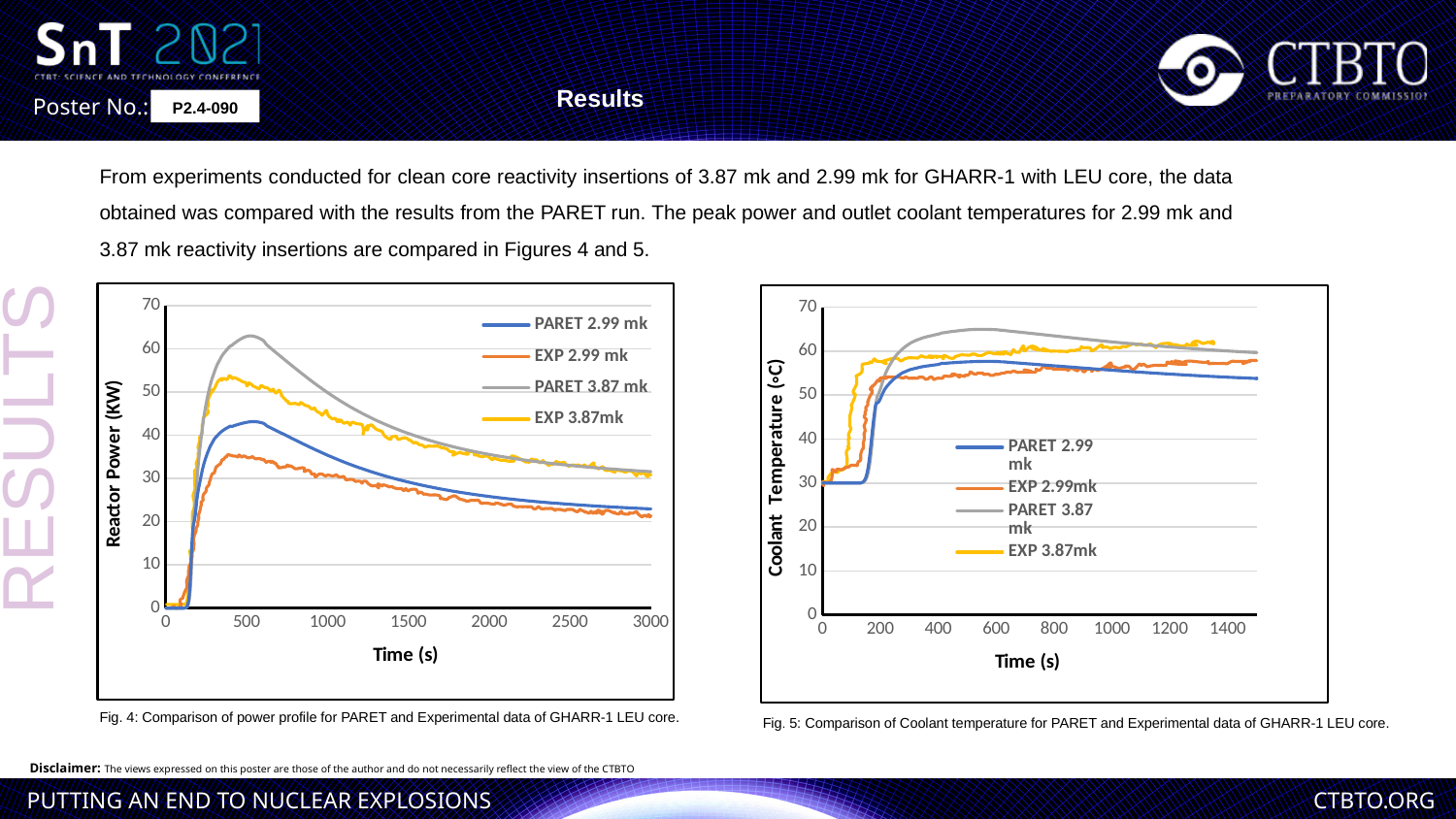
In the left chart (Fig. 4), is the peak value of EXP 2.99 mk greater or less than 40? less In the right chart (Fig. 5), is the value of PARET 2.99 mk at 1400 s greater or less than 60? less What kind of chart is the left chart (Fig. 4)? line chart How many series does the legend of the right chart (Fig. 5) list? 4 How many series does the legend of the left chart (Fig. 4) list? 4 In the left chart (Fig. 4), is the peak value of PARET 3.87 mk greater or less than 60? greater What is the y-axis label of the left chart (Fig. 4)? Reactor Power (KW) In the left chart (Fig. 4), does the PARET 2.99 mk series rise or fall between 1000 s and 3000 s? fall In the left chart (Fig. 4), which series has the lowest peak reactor power? EXP 2.99 mk In the right chart (Fig. 5), which series reaches the highest coolant temperature? PARET 3.87 mk In the left chart (Fig. 4), which series reaches the highest peak reactor power? PARET 3.87 mk What kind of chart is the right chart (Fig. 5)? line chart